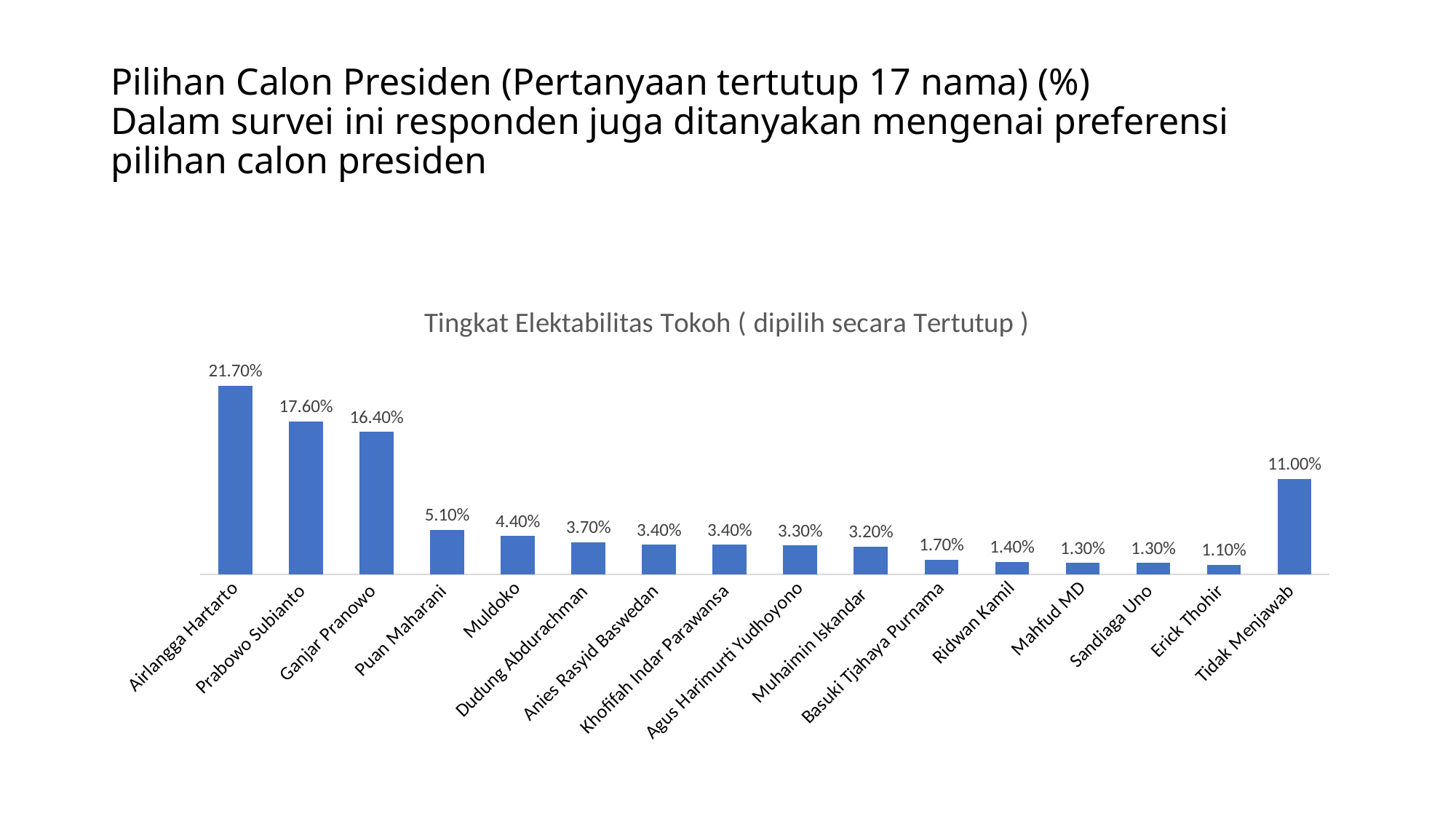
What is the value for Anies Rasyid Baswedan? 3.40% What is the value for Ganjar Pranowo? 16.40% What is the difference between the values for Puan Maharani and Muldoko? 0.70% What is the difference between the values for Airlangga Hartarto and Prabowo Subianto? 4.10% What is the value for Airlangga Hartarto? 21.70% Which category has the lowest value? Erick Thohir Which is larger, the value for Tidak Menjawab or the value for Puan Maharani? Tidak Menjawab What kind of chart is shown on the slide? Bar chart How many categories are shown on the x axis? 16 What is the value for Tidak Menjawab? 11.00% What is the title of the chart? Tingkat Elektabilitas Tokoh ( dipilih secara Tertutup ) Which category has the highest value? Airlangga Hartarto